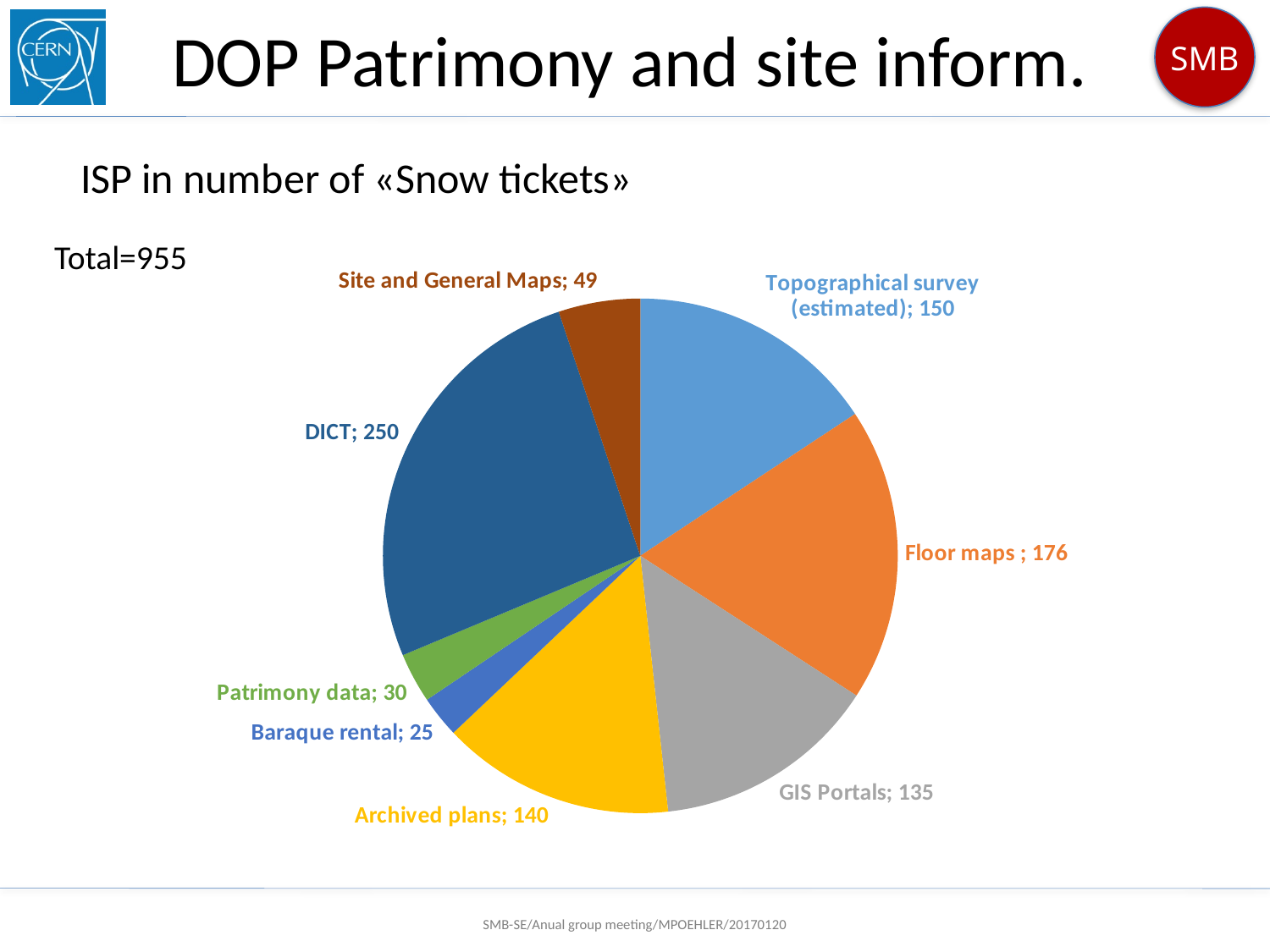
How many slices does the pie chart have? 8 What is the difference between Floor maps and GIS Portals? 41 What is the value for DICT? 250 What is the value for Floor maps? 176 Which category has the largest slice? DICT What is the value for Baraque rental? 25 Which category has the smallest slice? Baraque rental What is the total number of Snow tickets shown on the slide? 955 What kind of chart is shown on the slide? pie chart What share of the total does DICT represent? 26.2% What colour is the Archived plans slice? yellow Which is larger, Topographical survey (estimated) or Archived plans? Topographical survey (estimated)